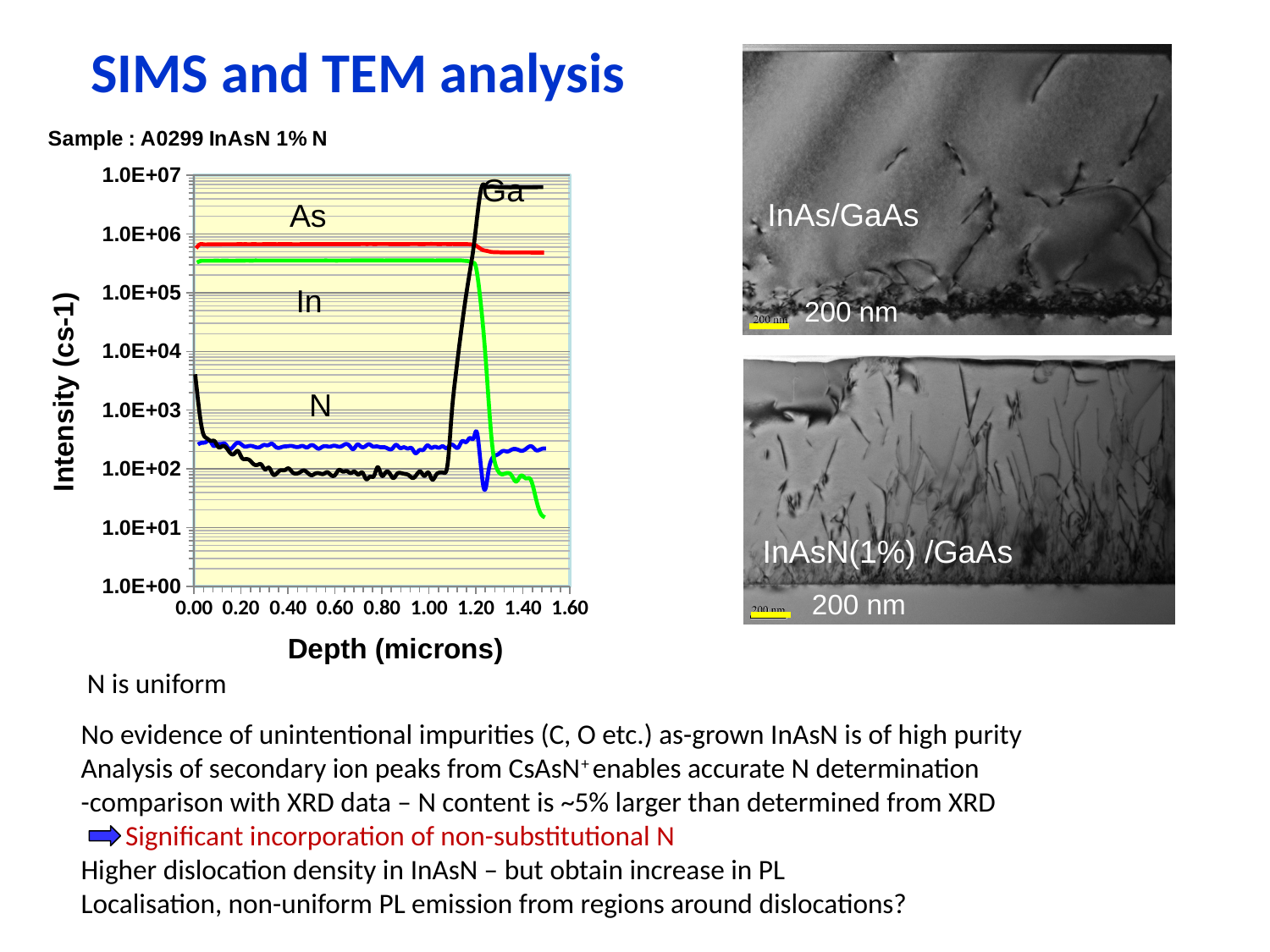
How many element traces are labelled on the SIMS depth profile chart? 4 On the SIMS depth profile chart, at a depth of 0.50 microns, which is higher: the In intensity or the N intensity? In What is the title of the y axis of the SIMS depth profile chart? Intensity (cs-1) On the SIMS depth profile chart, is the N intensity at 0.50 microns greater or less than 1.0E+03? less On the SIMS depth profile chart, at a depth of 1.40 microns, which is higher: the Ga intensity or the As intensity? Ga On the SIMS depth profile chart, which element has the highest intensity at a depth of 0.50 microns? As On the SIMS depth profile chart, is the Ga intensity at 1.40 microns greater or less than 1.0E+06? greater On the SIMS depth profile chart, which element has the lowest intensity at a depth of 0.50 microns? Ga What kind of chart is the SIMS depth profile on the left of the slide? line chart On the SIMS depth profile chart, does the Ga intensity rise or fall as depth increases from 1.00 to 1.20 microns? rise On the SIMS depth profile chart, is the As intensity at 0.50 microns greater or less than 1.0E+05? greater What is the title of the x axis of the SIMS depth profile chart? Depth (microns)